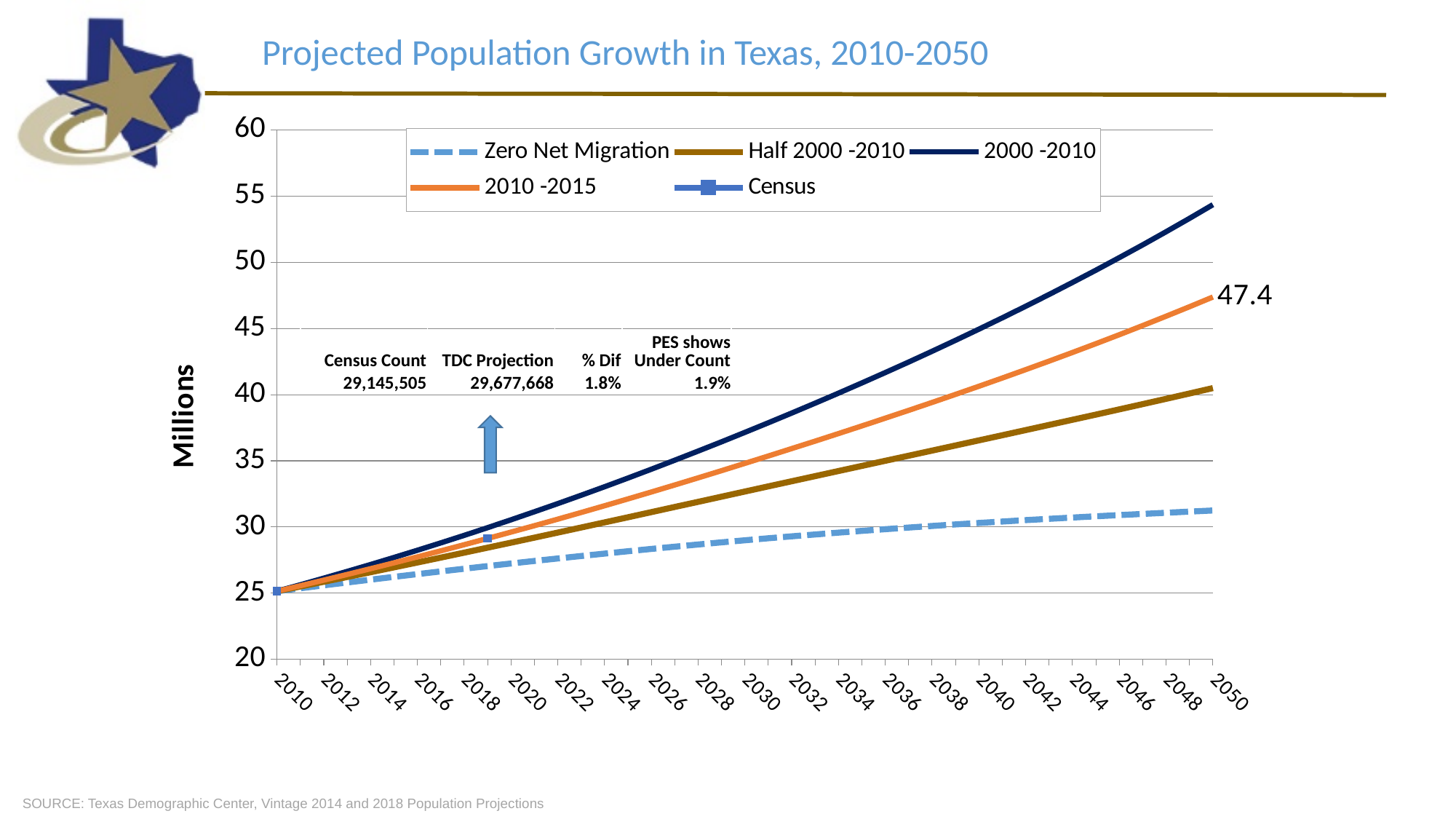
How many year labels are shown on the x axis? 21 Which series has the lowest value in 2050? Zero Net Migration What kind of chart is shown on the slide? line chart Is the value for the Zero Net Migration series in 2050 greater or less than 35? less In 2040, which is larger: the 2010 -2015 series or the Half 2000 -2010 series? 2010 -2015 How many series does the chart legend list? 5 What is the label on the y axis of the chart? Millions Does the Zero Net Migration series rise or fall from 2010 to 2050? rise What value is labelled for the 2010 -2015 series in 2050? 47.4 Which series has the highest value in 2050? 2000 -2010 Is the value for the Half 2000 -2010 series in 2050 greater or less than 45? less Is the value for the 2000 -2010 series in 2050 greater or less than 50? greater